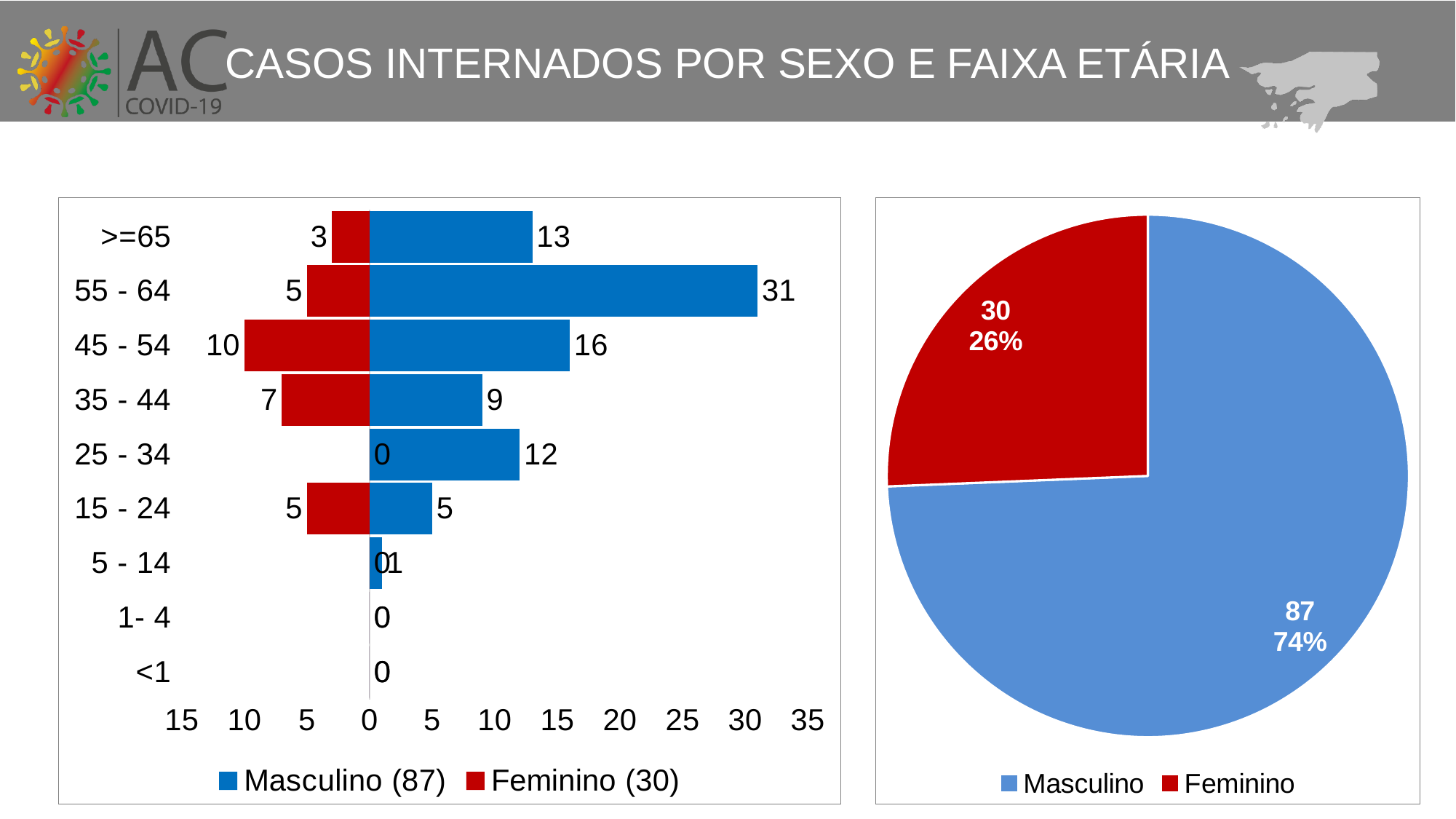
In the bar chart on the left, how many series does the legend list? 2 In the bar chart on the left, how many age groups are shown on the vertical axis? 9 In the bar chart on the left, what is the Feminino value for the 45 - 54 age group? 10 In the bar chart on the left, which age group has the highest Feminino value? 45 - 54 In the pie chart on the right, what share of the pie does Feminino represent? 26% What kind of chart is shown on the left of the slide? Bar chart In the pie chart on the right, what is the total of the Masculino and Feminino values? 117 In the bar chart on the left, which is larger for the 15 - 24 age group, the Masculino value or the Feminino value? They are equal (5) In the bar chart on the left, what is the Masculino value for the 55 - 64 age group? 31 In the bar chart on the left, which age group has the highest Masculino value? 55 - 64 In the bar chart on the left, what is the difference between the Masculino and Feminino values for the 35 - 44 age group? 2 In the pie chart on the right, what is the value for Masculino? 87